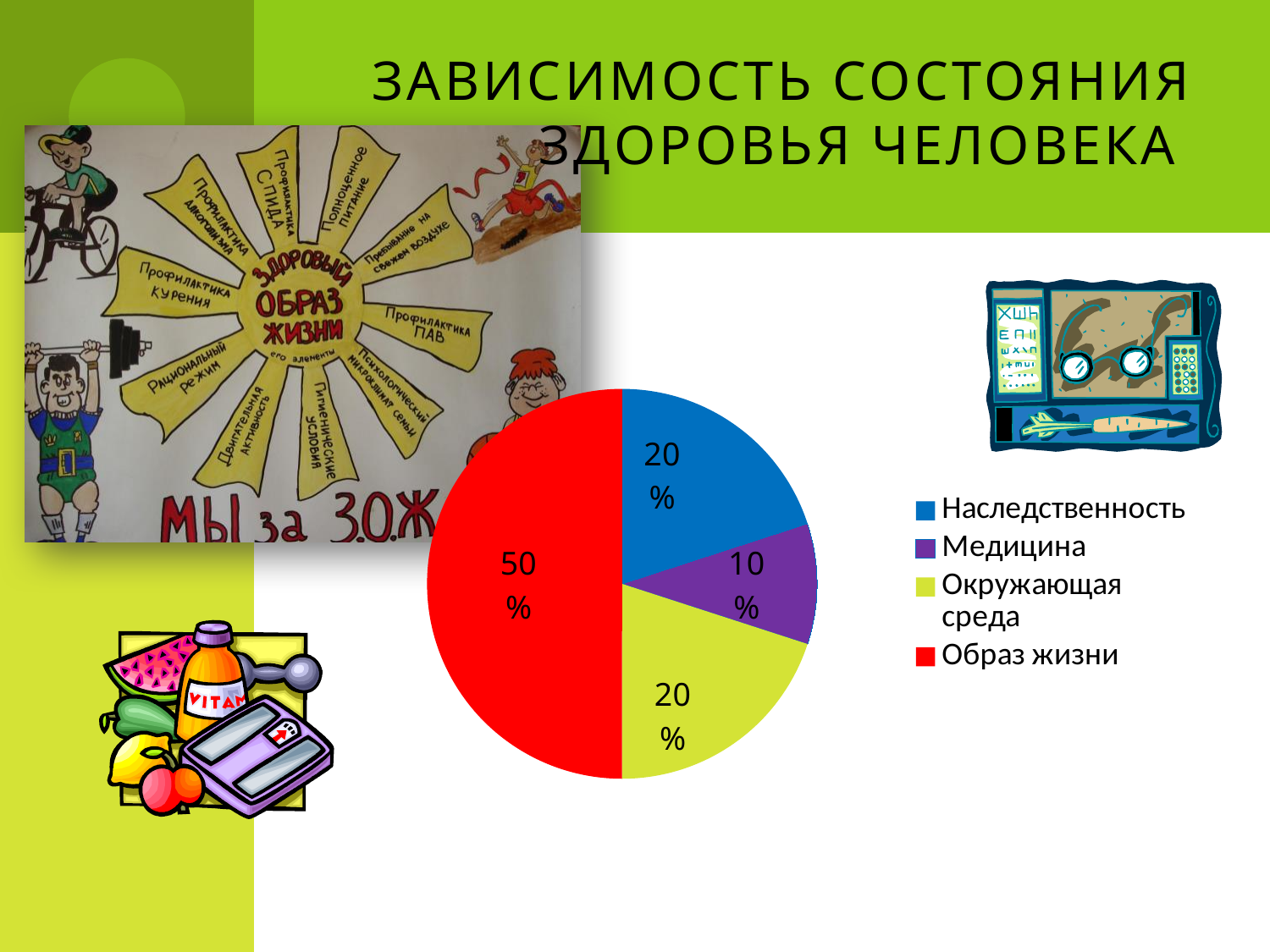
Which is larger, the slice for Наследственность or the slice for Медицина? Наследственность What colour is the slice for Образ жизни? red What is the value shown for Наследственность? 20% Which category has the smallest slice of the pie? Медицина What is the value shown for Окружающая среда? 20% What is the value shown for Медицина? 10% What share of the pie does Образ жизни have? 50% What kind of chart is shown on the slide? pie chart Which category has the largest slice of the pie? Образ жизни How many entries does the legend list? 4 How many slices does the pie chart have? 4 What is the difference between the values for Образ жизни and Медицина? 40%